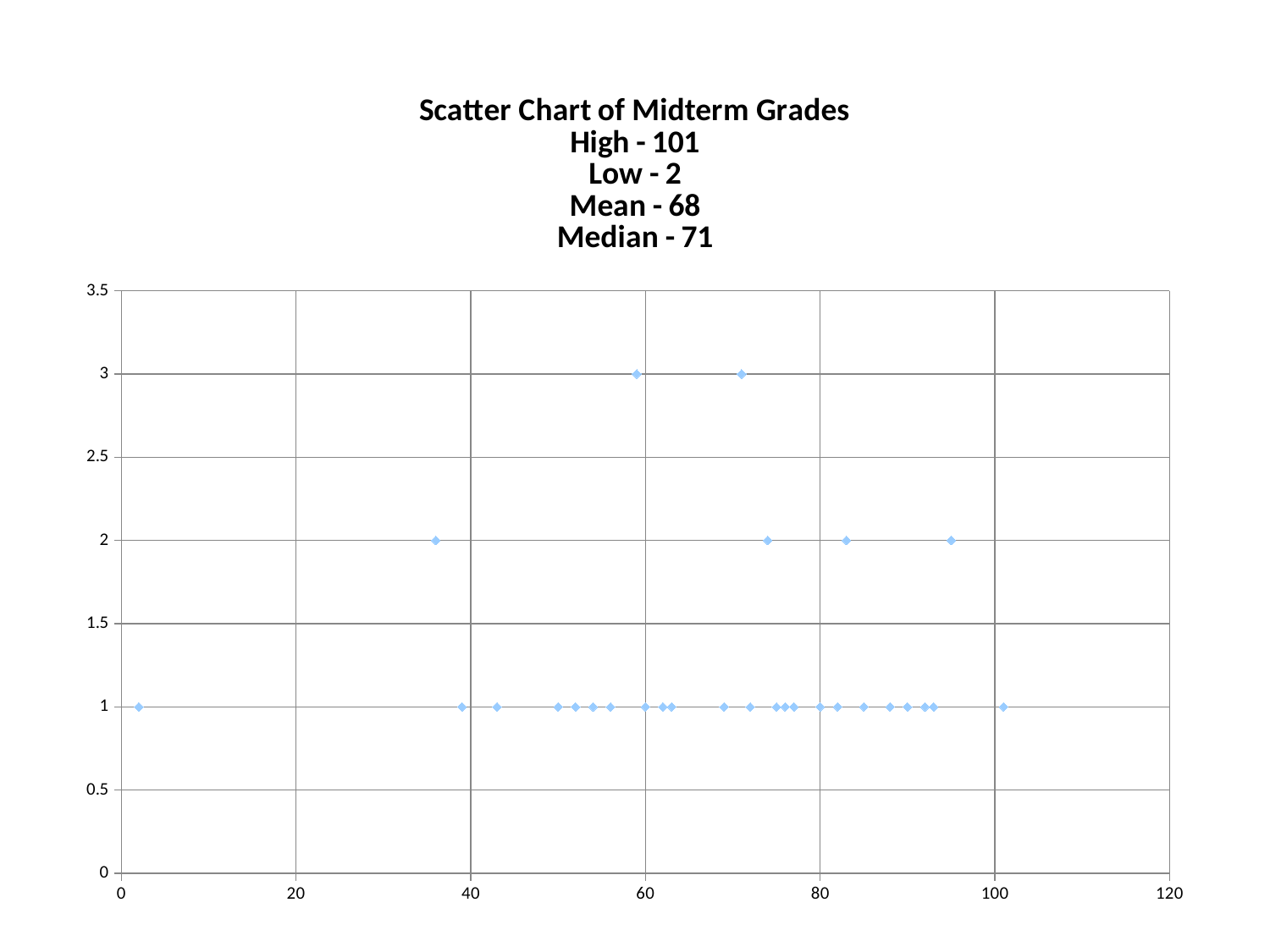
According to the chart title, what is the high midterm grade? 101 Which is larger: the median midterm grade or the mean midterm grade shown in the title? Median How many points on the scatter chart lie at a y value of 2? 4 According to the chart title, what is the mean midterm grade? 68 Is the x value of the rightmost point on the scatter chart greater or less than 100? greater How many points on the scatter chart lie at a y value of 3? 2 What kind of chart is shown on the slide? Scatter chart According to the chart title, what is the median midterm grade? 71 Is the x value of the leftmost point on the scatter chart greater or less than 20? less What is the highest y-axis value reached by any point on the scatter chart? 3 According to the chart title, what is the low midterm grade? 2 What is the title of the chart? Scatter Chart of Midterm Grades